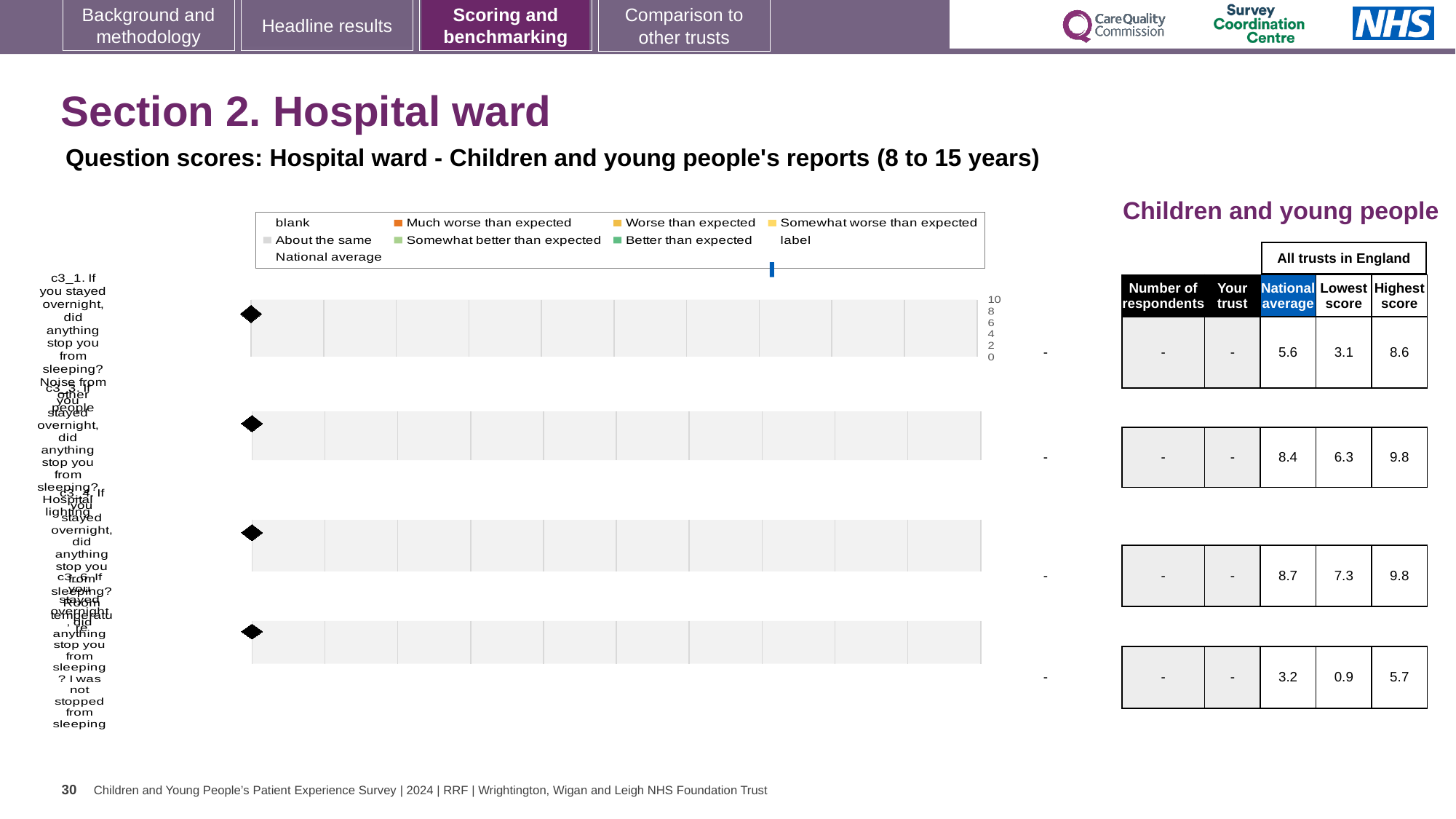
In the table beside the chart, what is the national average for the first row (c3_1, noise from other people)? 5.6 How many question bars are plotted in the chart? 4 What colour does the legend use for 'Better than expected'? green In the table beside the chart, what is the lowest score for the second row? 6.3 What colour does the legend use for 'Much worse than expected'? orange What kind of chart is shown on the slide? bar chart In the table beside the chart, what is the national average for the third row? 8.7 In the table beside the chart, is the national average for the second row (8.4) larger or smaller than for the third row (8.7)? smaller In the table beside the chart, what is the highest score for the first row (c3_1, noise from other people)? 8.6 In the table beside the chart, what is the lowest score for the fourth row? 0.9 In the table beside the chart, what is the difference between the highest and lowest score in the fourth row? 4.8 In the table beside the chart, which row has the lowest national average? the fourth row (3.2)